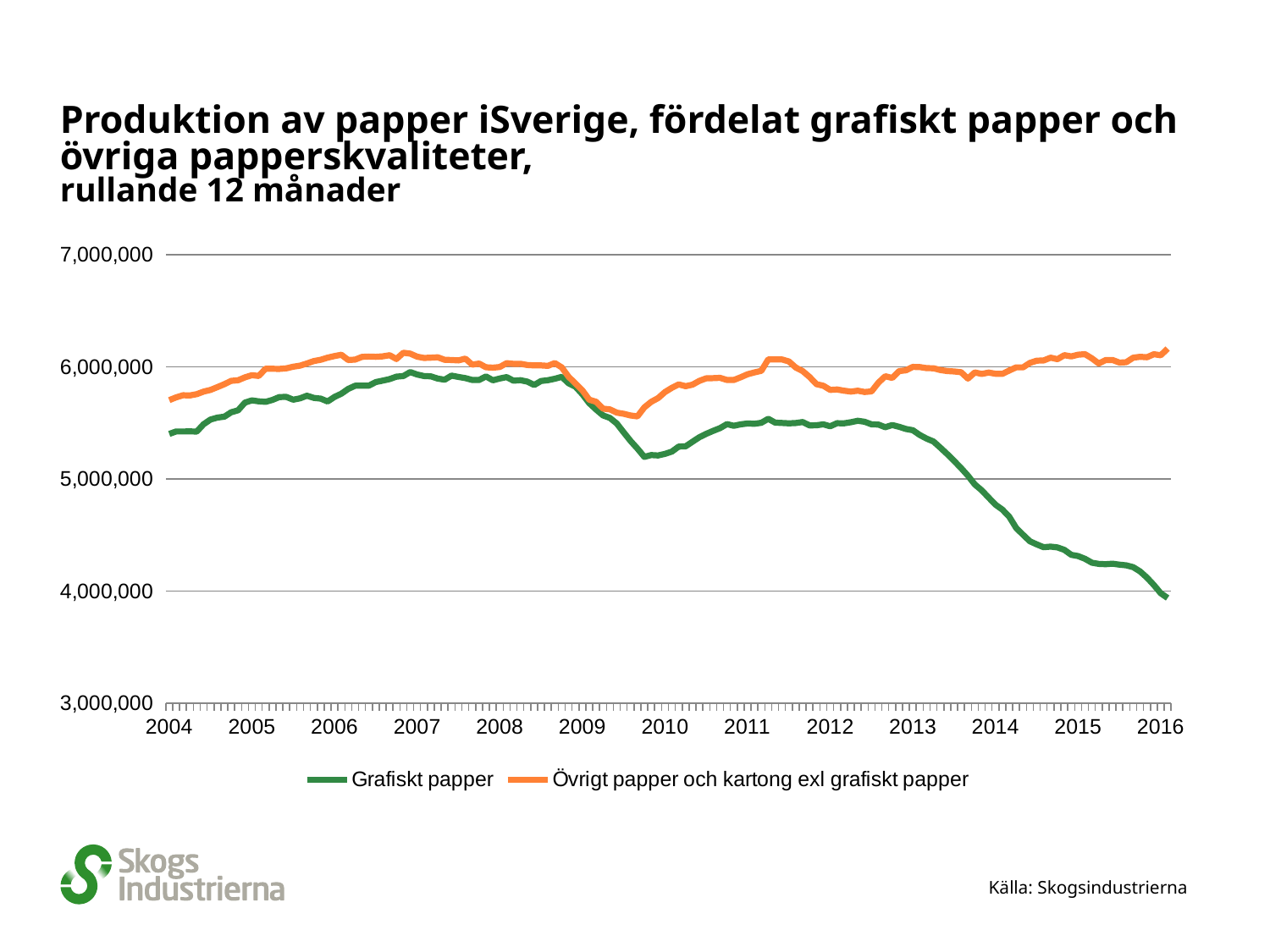
Is the value for Övrigt papper och kartong exl grafiskt papper in 2016 greater or less than 6,000,000? greater How many series does the legend list? 2 Is the value for Övrigt papper och kartong exl grafiskt papper at the start of 2010 greater or less than 6,000,000? less Does the Grafiskt papper line rise or fall between 2013 and 2016? Fall How many year labels are shown on the x axis? 13 Which series has the higher value in 2016, Grafiskt papper or Övrigt papper och kartong exl grafiskt papper? Övrigt papper och kartong exl grafiskt papper Does the Övrigt papper och kartong exl grafiskt papper line rise or fall overall between 2010 and 2016? Rise What is the source cited at the bottom of the slide? Skogsindustrierna Is the value for Grafiskt papper in 2014 greater or less than 5,000,000? less Which series is drawn in green? Grafiskt papper What kind of chart is shown on the slide? Line chart